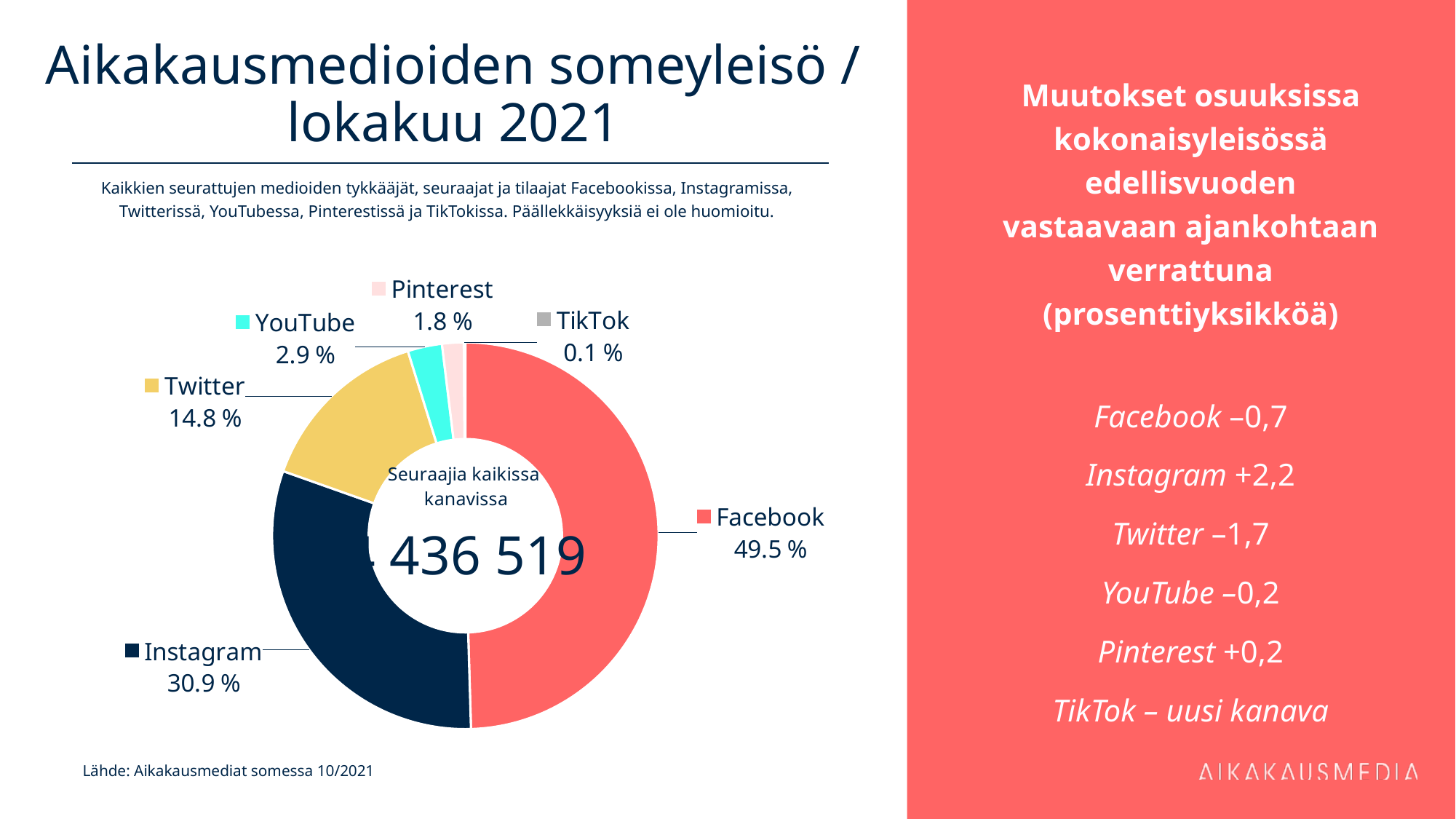
What is the value shown for Pinterest in the chart? 1.8 % What share of the donut chart does Facebook hold? 49.5 % What share of the donut chart does Instagram hold? 30.9 % What is the value shown for Twitter in the chart? 14.8 % Which has a larger share, Twitter or YouTube? Twitter What colour is the Twitter slice in the chart? Yellow What is the value shown for YouTube in the chart? 2.9 % Which channel has the smallest share in the chart? TikTok How many channels are shown in the chart? 6 Which channel has the largest share in the chart? Facebook What is the difference in percentage points between Facebook's and Instagram's shares? 18.6 What type of chart is shown on the slide? Donut (pie) chart